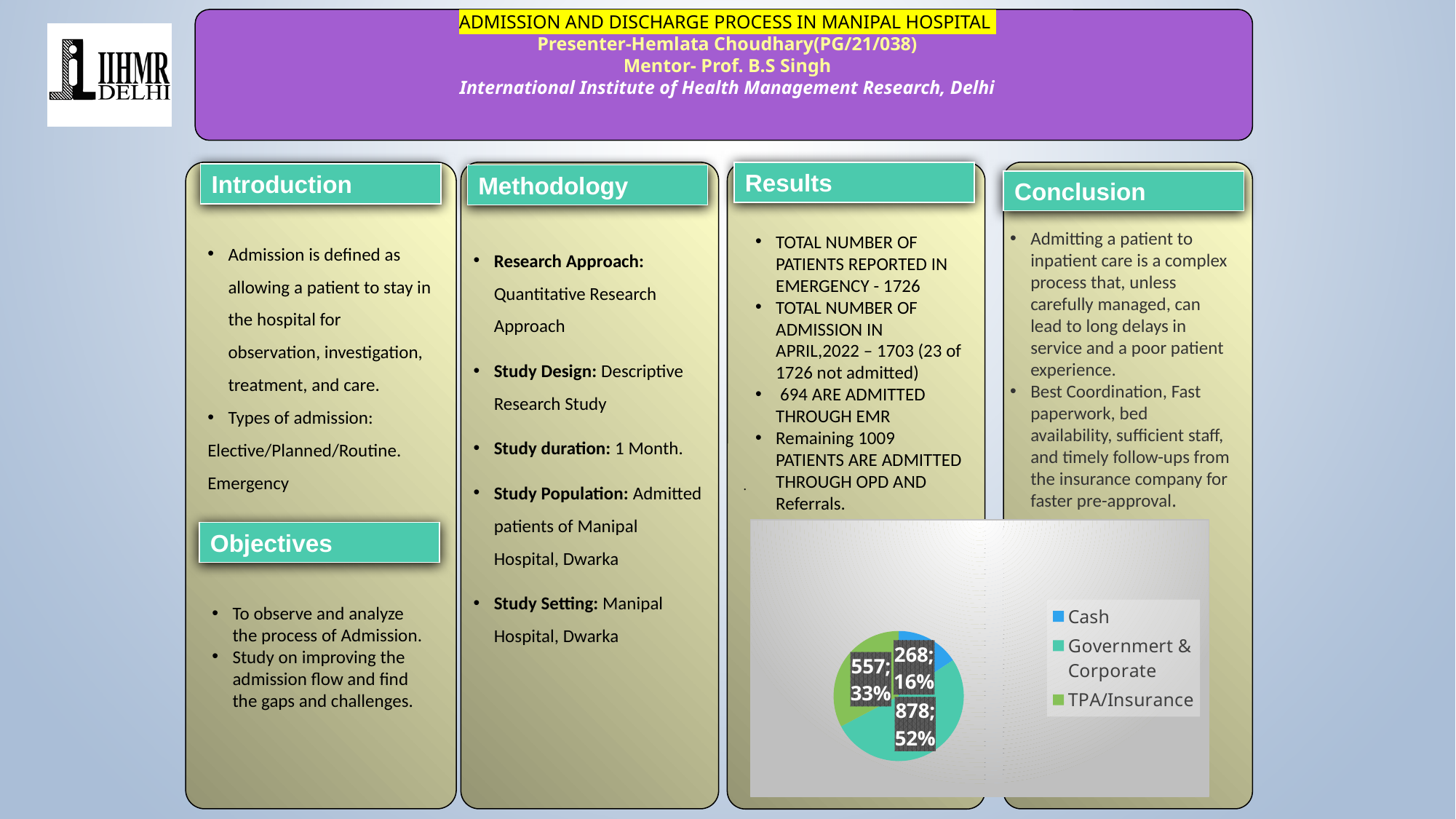
What is the value shown for the Government & Corporate slice of the pie chart? 878 How many entries does the pie chart's legend list? 3 How many slices does the pie chart have? 3 What is the number of patients in the Cash slice of the pie chart? 268 What is the value shown for the TPA/Insurance slice of the pie chart? 557 What kind of chart is shown in the Results section? Pie chart Which category has the largest slice in the pie chart? Governmert & Corporate What percentage share does the Cash slice represent in the pie chart? 16% What percentage of the pie chart is the Government & Corporate slice? 52% What is the difference between the Government & Corporate value and the TPA/Insurance value in the pie chart? 321 Which is larger in the pie chart, the TPA/Insurance slice or the Cash slice? TPA/Insurance Which category has the smallest slice in the pie chart? Cash